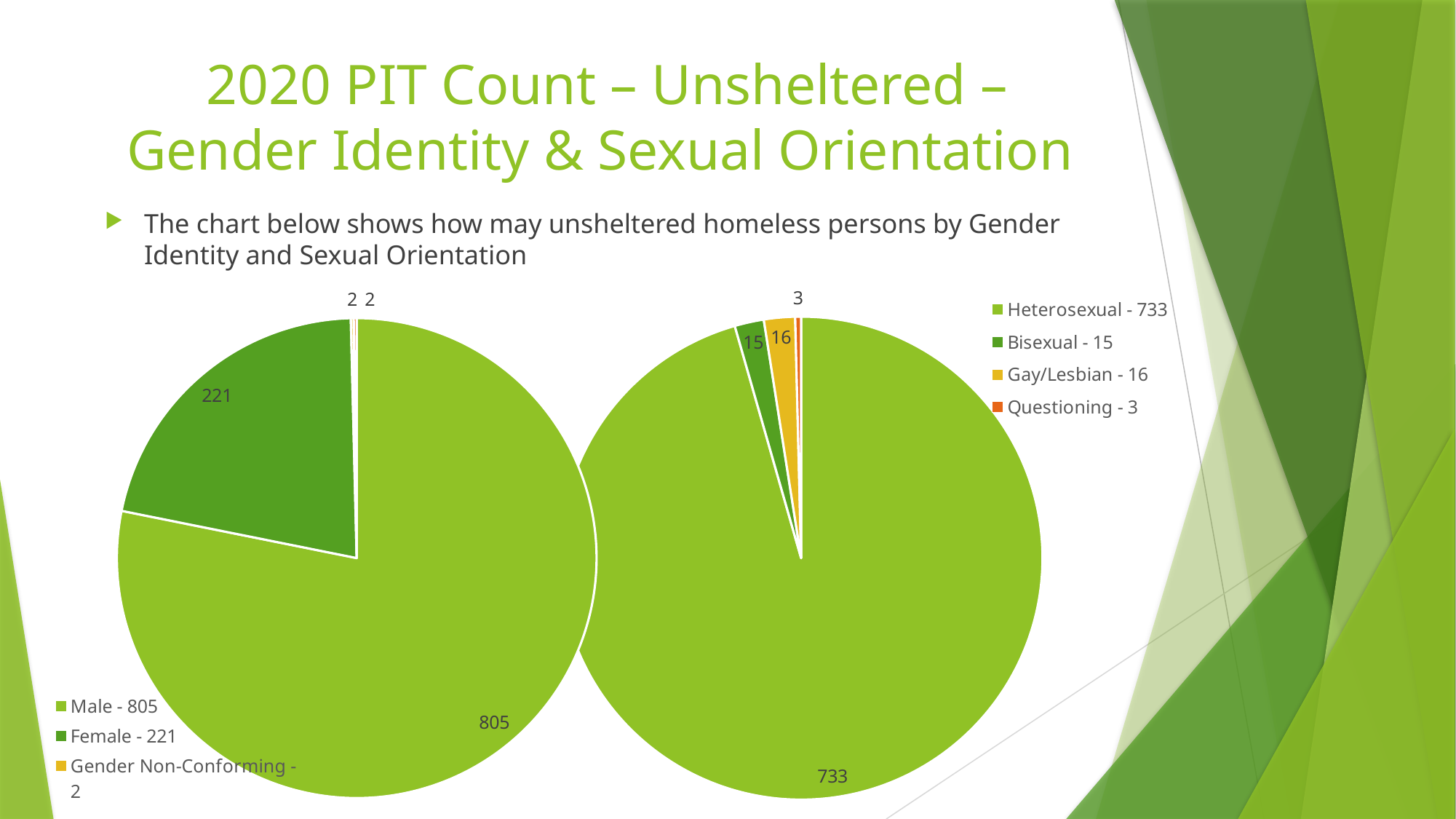
In the left pie chart, what is the difference between the Male and Female values? 584 In the right pie chart, which category has the largest slice? Heterosexual In the right pie chart, what is the value for Gay/Lesbian? 16 In the right pie chart, which category has the smallest slice? Questioning In the left pie chart, what is the value for Female? 221 In the left pie chart, what is the value for Male? 805 In the left pie chart, which category has the largest slice? Male How many entries does the legend of the right pie chart list? 4 In the right pie chart, what is the value for Questioning? 3 In the right pie chart, what is the difference between the Heterosexual and Bisexual values? 718 What type of chart is used on this slide? Pie chart In the right pie chart, which is larger, Bisexual or Gay/Lesbian? Gay/Lesbian